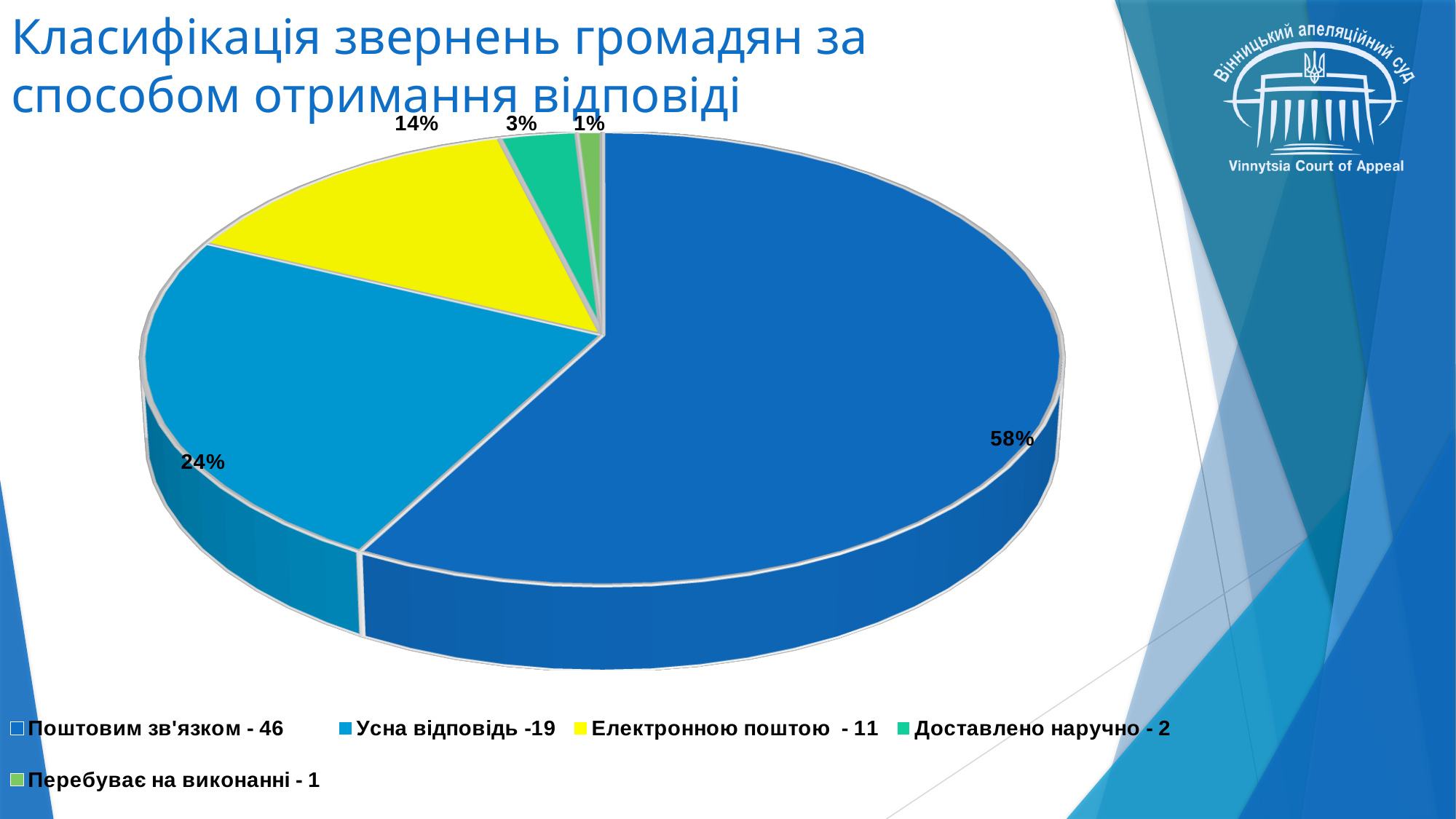
What percentage share does the slice for "Доставлено наручно" have? 3% What percentage share does the slice for "Усна відповідь" have? 24% Which category has the largest slice of the pie? Поштовим зв'язком What is the difference in percentage points between the "Поштовим зв'язком" slice and the "Усна відповідь" slice? 34 percentage points What percentage share does the slice for "Перебуває на виконанні" have? 1% What type of chart is shown on the slide? Pie chart How many categories does the pie chart show? 5 According to the legend, how many appeals are listed for "Усна відповідь"? 19 Which category has the smallest slice of the pie? Перебуває на виконанні Which slice is larger: "Електронною поштою" or "Доставлено наручно"? Електронною поштою